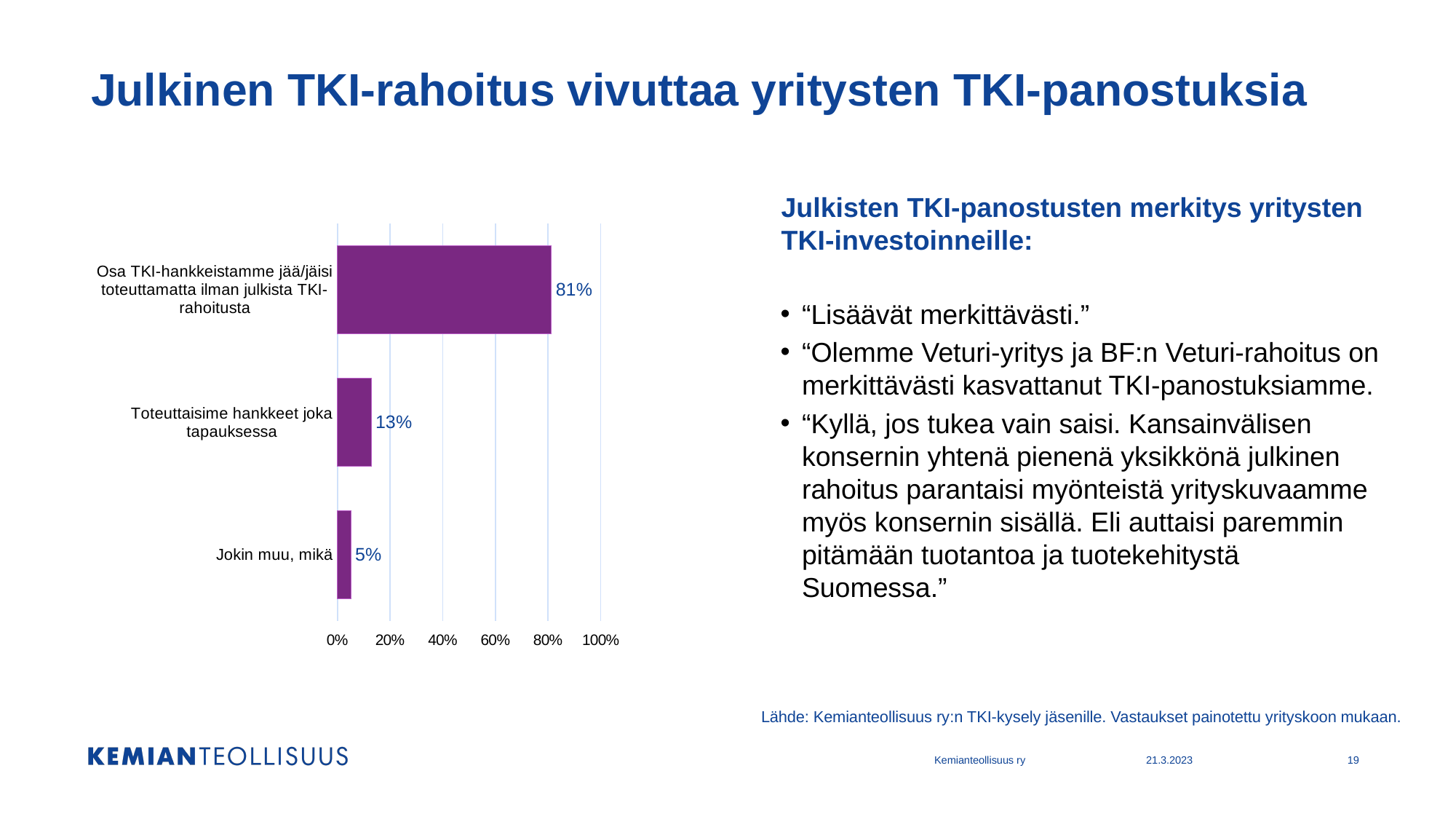
What is the value for "Jokin muu, mikä"? 5% What kind of chart is shown on the slide? bar chart What is the value for "Osa TKI-hankkeistamme jää/jäisi toteuttamatta ilman julkista TKI-rahoitusta"? 81% What is the difference between the values for "Toteuttaisime hankkeet joka tapauksessa" and "Jokin muu, mikä"? 8% Which is larger: the value for "Toteuttaisime hankkeet joka tapauksessa" or the value for "Jokin muu, mikä"? Toteuttaisime hankkeet joka tapauksessa What is the difference between the values for "Osa TKI-hankkeistamme jää/jäisi toteuttamatta ilman julkista TKI-rahoitusta" and "Toteuttaisime hankkeet joka tapauksessa"? 68% Which category has the highest value? Osa TKI-hankkeistamme jää/jäisi toteuttamatta ilman julkista TKI-rahoitusta Which category has the lowest value? Jokin muu, mikä Is the value for "Osa TKI-hankkeistamme jää/jäisi toteuttamatta ilman julkista TKI-rahoitusta" greater or less than 60%? greater What is the maximum value shown on the chart's horizontal axis? 100% How many categories are shown in the chart? 3 What is the value for "Toteuttaisime hankkeet joka tapauksessa"? 13%